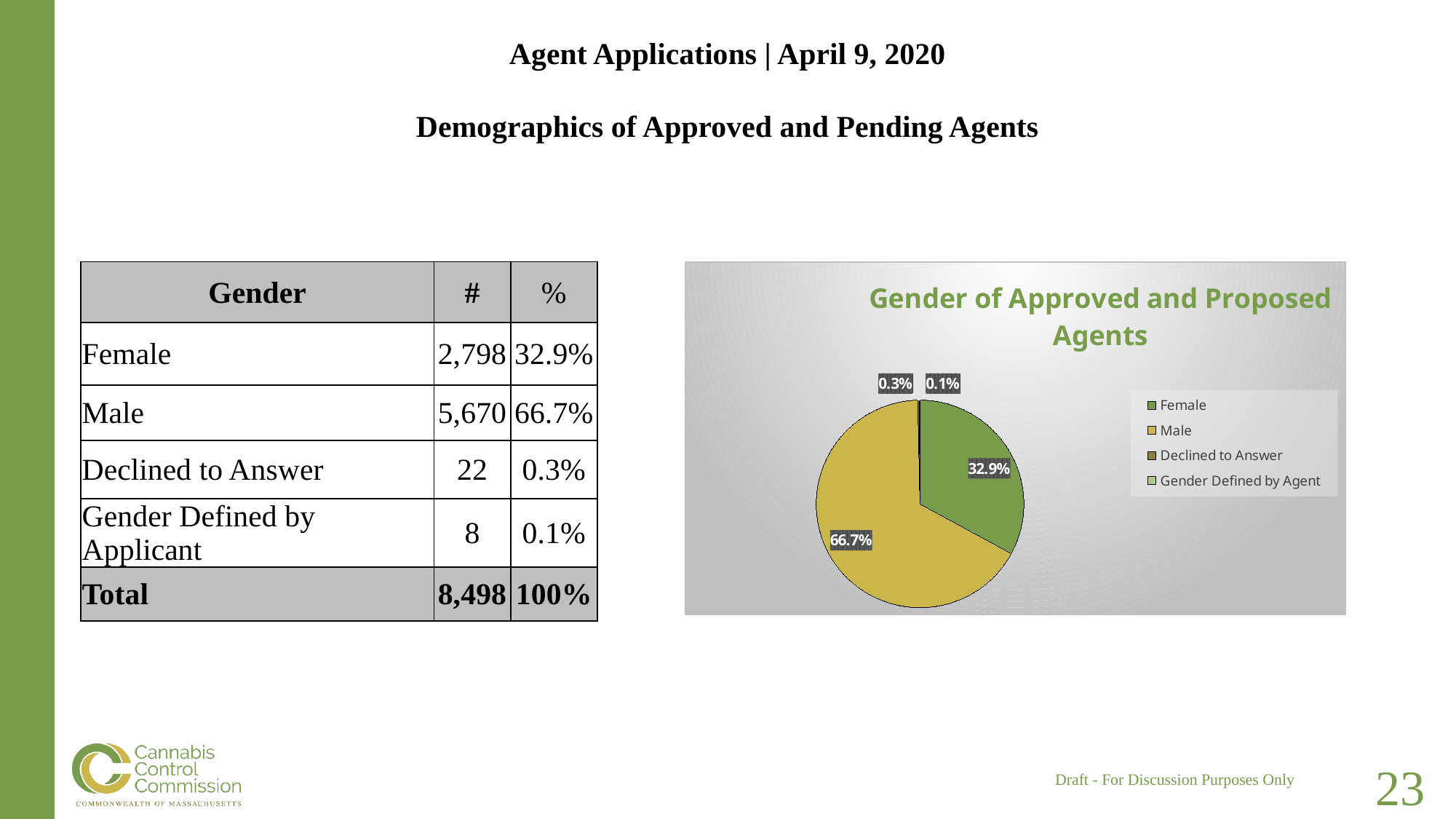
Which category has the smallest slice in the pie chart? Gender Defined by Agent What percentage is shown for Declined to Answer in the pie chart? 0.3% Which slice is larger in the pie chart, Female or Male? Male What percentage is shown for Gender Defined by Agent in the pie chart? 0.1% Which colour represents Male in the pie chart? yellow What share of the pie does the Male slice represent? 66.7% What is the title of the pie chart? Gender of Approved and Proposed Agents What is the difference in percentage points between the Male and Female slices? 33.8 Which category has the largest slice in the pie chart? Male What share of the pie does the Female slice represent? 32.9% What kind of chart is shown on the slide? pie chart How many categories does the pie chart's legend list? 4